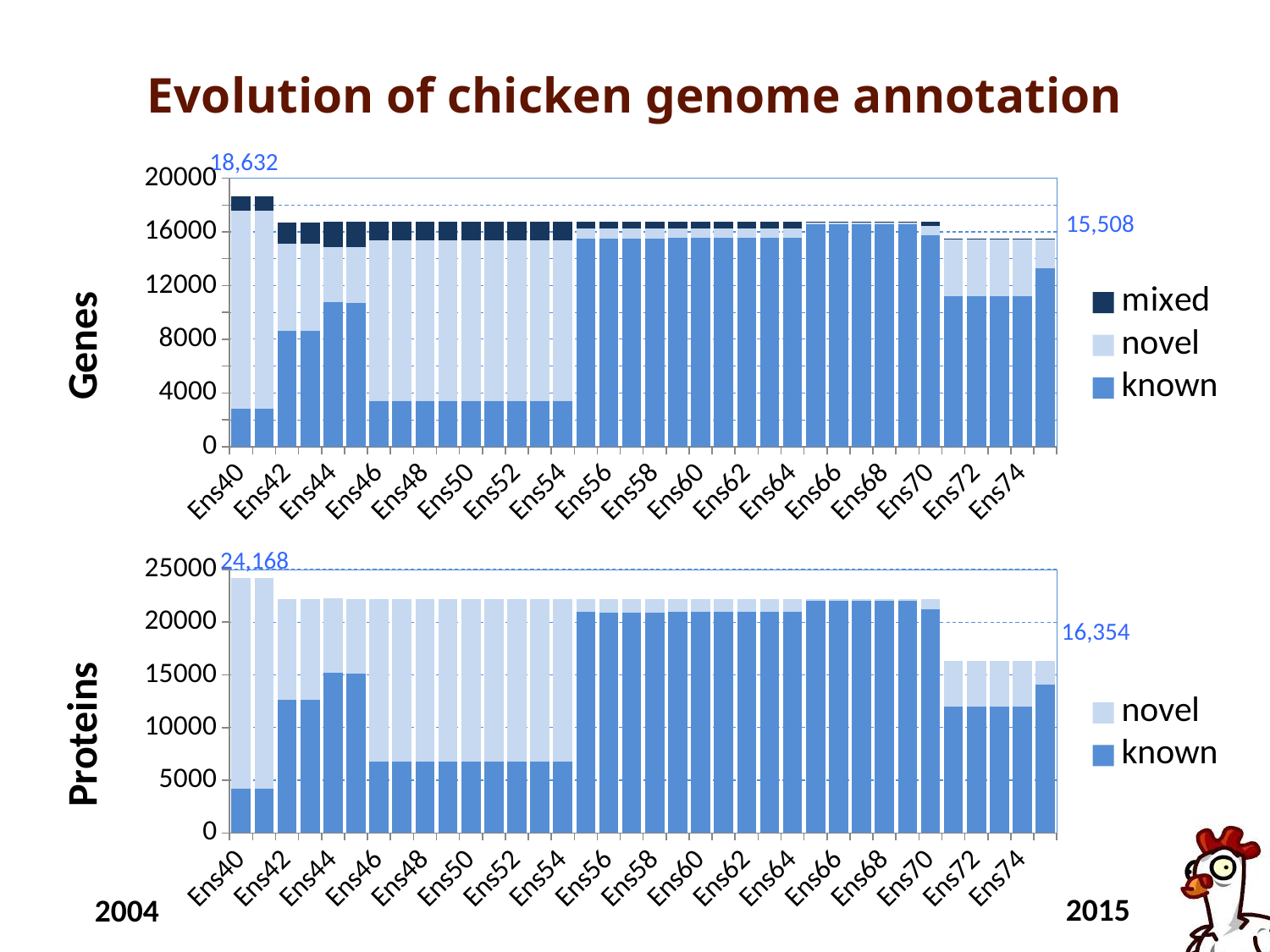
In the Genes chart, what total value is labelled for the latest releases (Ens72 onward)? 15,508 In the Proteins chart, what total value is labelled for the Ens40 bar? 24,168 In the Proteins chart, is the known value for Ens48 greater or less than 5000? greater In the Genes chart, what total value is labelled for the Ens40 bar? 18,632 How many series does the legend of the Proteins chart list? 2 In the Genes chart, is the known value for Ens40 greater or less than 4000? less In the Genes chart, which has the larger known value, Ens44 or Ens48? Ens44 How many series does the legend of the Genes chart list? 3 In the Proteins chart, what total value is labelled for the latest releases (Ens72 onward)? 16,354 In the Proteins chart, what is the difference between the labelled Ens40 total (24,168) and the labelled latest total (16,354)? 7,814 What kind of chart is the Genes chart on the slide? Stacked bar chart In the Genes chart, what is the difference between the labelled Ens40 total (18,632) and the labelled latest total (15,508)? 3,124